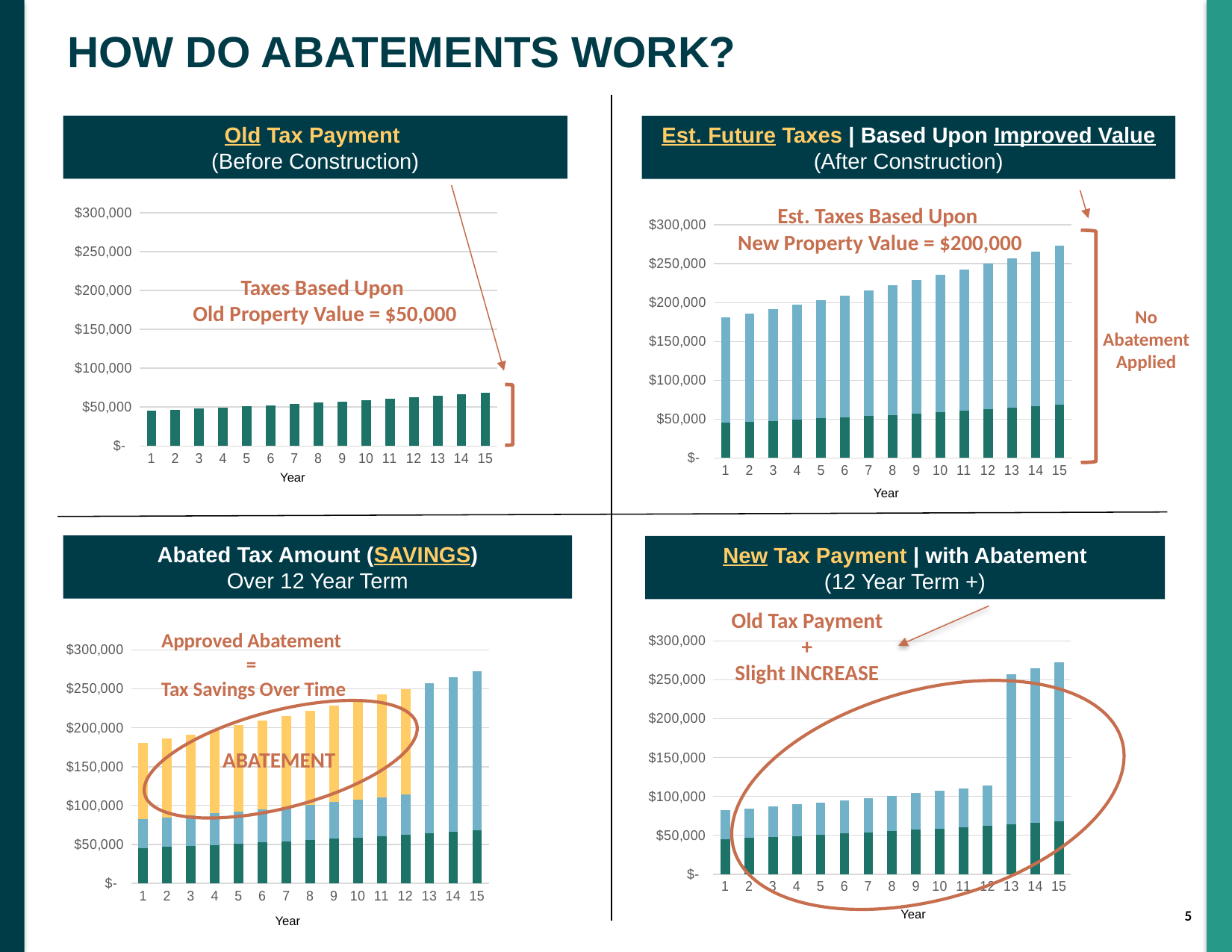
In the 'New Tax Payment | with Abatement' chart, which is larger, the total for year 12 or the total for year 13? year 13 In the 'Old Tax Payment (Before Construction)' chart, is the value for year 15 greater or less than $100,000? less In the 'Old Tax Payment (Before Construction)' chart, how many years are plotted on the x axis? 15 In the 'New Tax Payment | with Abatement' chart, is the total for year 1 greater or less than $100,000? less In the 'Est. Future Taxes | Based Upon Improved Value' chart, is the total for year 1 greater or less than $200,000? less How many charts are on the slide? 4 In the 'Abated Tax Amount (SAVINGS)' chart, how many years have a yellow (abatement) segment? 12 In the 'Old Tax Payment (Before Construction)' chart, what kind of chart is shown? bar chart In the 'Est. Future Taxes | Based Upon Improved Value' chart, which year has the lowest total? 1 In the 'Old Tax Payment (Before Construction)' chart, do the values rise or fall from year 1 to year 15? rise In the 'Old Tax Payment (Before Construction)' chart, which year has the highest value? 15